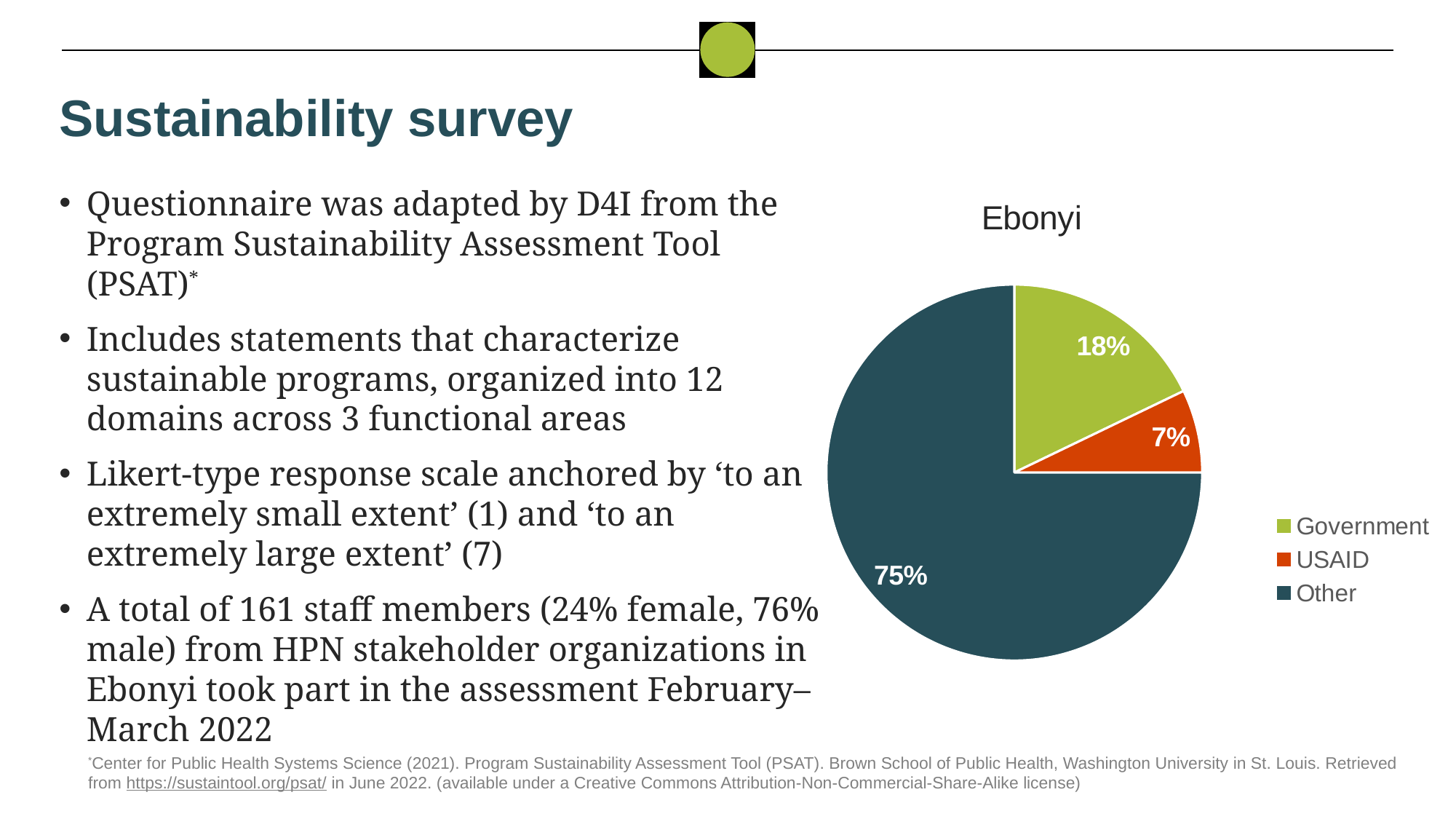
What share of the pie chart is Government? 18% Which colour represents USAID in the pie chart? Orange-red Which category has the smallest slice of the pie chart? USAID What share of the pie chart is USAID? 7% How many categories does the pie chart show? 3 Which slice is larger, Government or USAID? Government Which category has the largest slice of the pie chart? Other What share of the pie chart is Other? 75% What is the title of the chart? Ebonyi What type of chart is shown on the slide? Pie chart What is the difference in percentage points between the Government and USAID slices? 11 What is the difference in percentage points between the Other and Government slices? 57